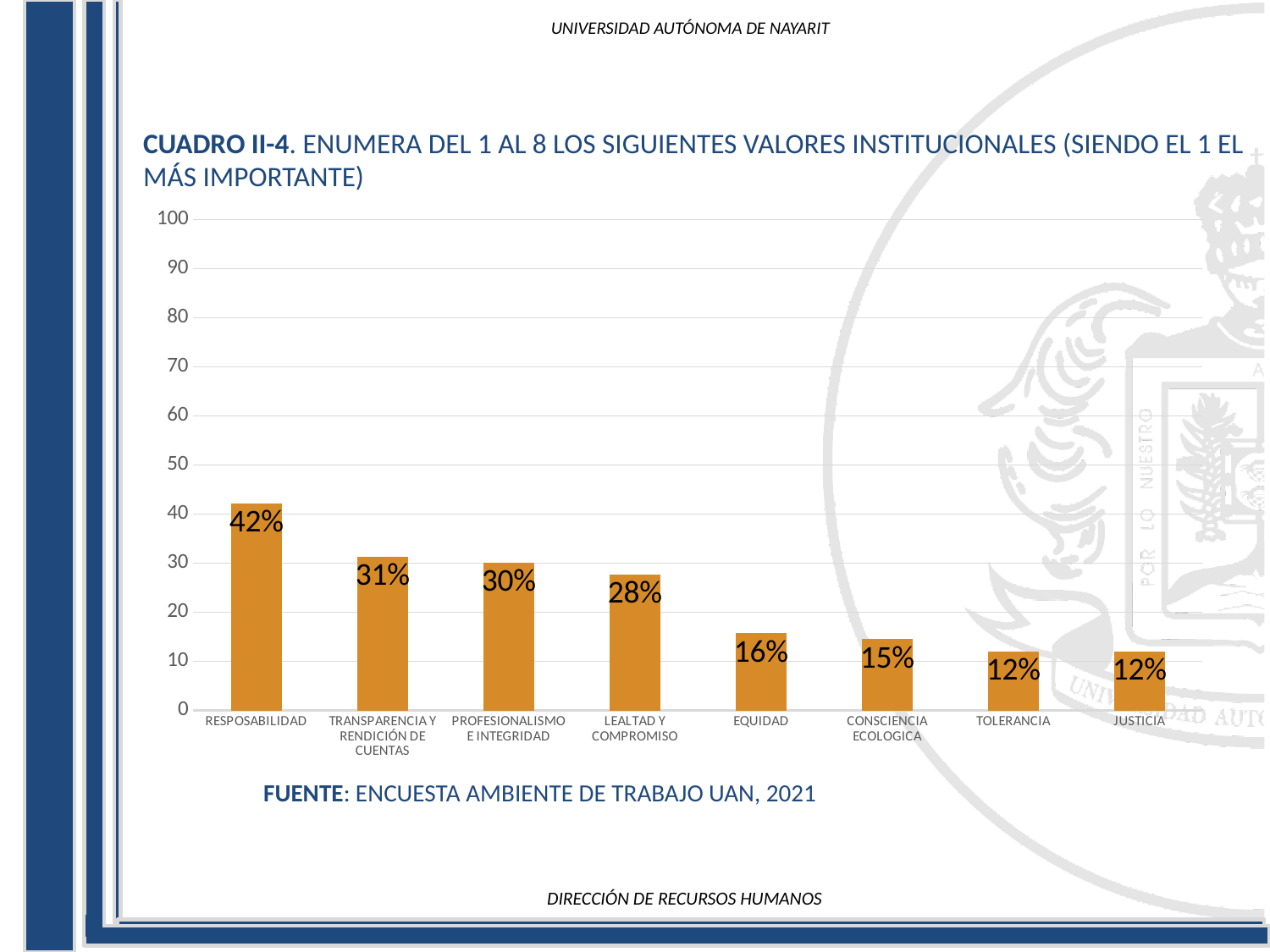
What kind of chart is shown on the slide? bar chart Which is larger, the value for PROFESIONALISMO E INTEGRIDAD or the value for LEALTAD Y COMPROMISO? PROFESIONALISMO E INTEGRIDAD What is the value for EQUIDAD? 16% How many categories are shown on the x axis? 8 What is the value for CONSCIENCIA ECOLOGICA? 15% Do the values generally rise or fall from left to right along the x axis? fall What source is cited below the chart? ENCUESTA AMBIENTE DE TRABAJO UAN, 2021 What is the difference between the values for RESPOSABILIDAD and TRANSPARENCIA Y RENDICIÓN DE CUENTAS? 11% Which category has the highest value? RESPOSABILIDAD What is the difference between the values for LEALTAD Y COMPROMISO and EQUIDAD? 12% What is the value for RESPOSABILIDAD? 42% Is the value for TRANSPARENCIA Y RENDICIÓN DE CUENTAS greater or less than 20? greater